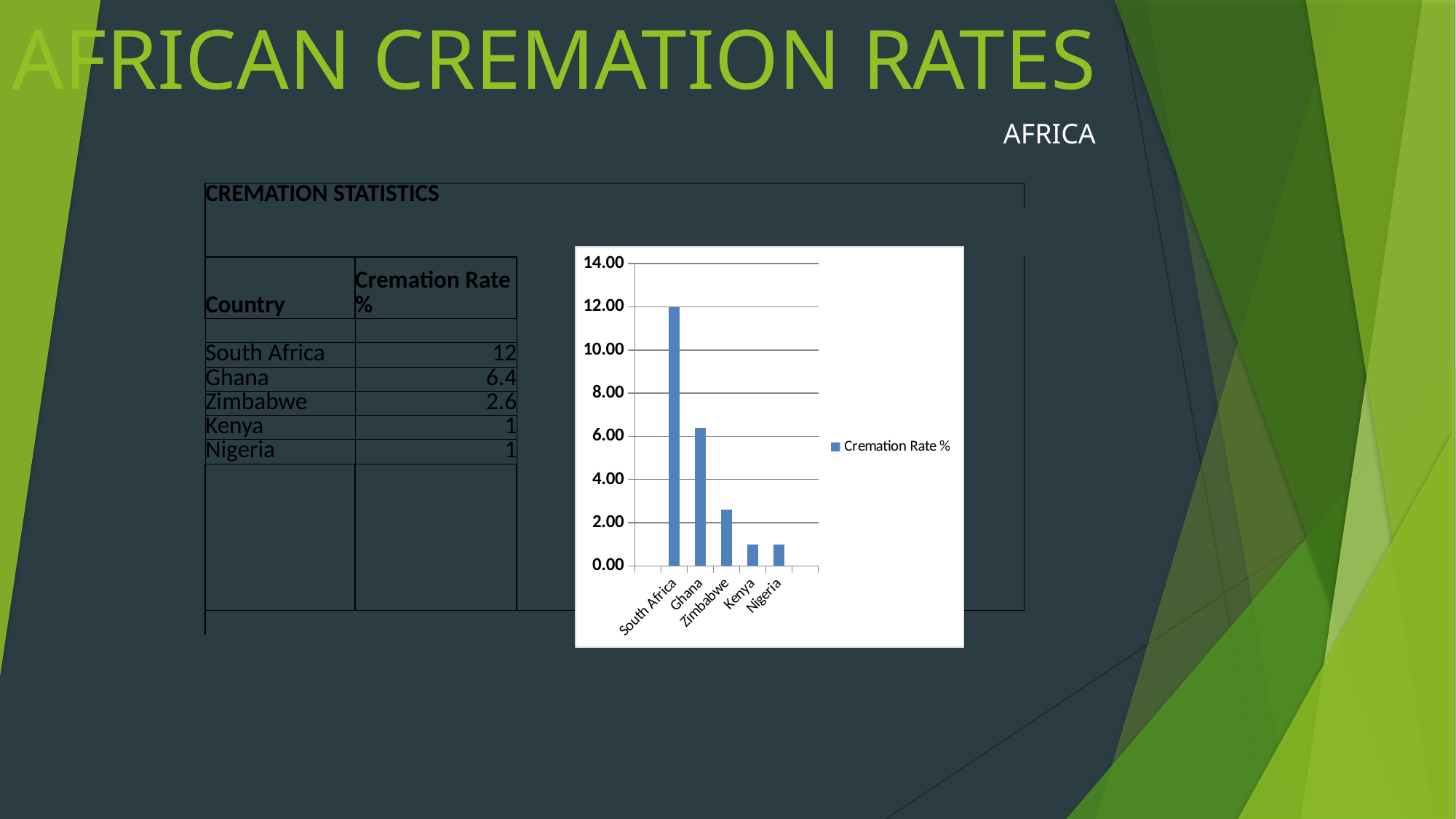
Which has a higher cremation rate, Ghana or Zimbabwe? Ghana Which country has the highest cremation rate in the chart? South Africa What is the cremation rate for South Africa? 12 How many countries are shown in the chart? 5 How many series does the chart legend list? 1 What is the cremation rate for Ghana? 6.4 What is the cremation rate for Zimbabwe? 2.6 What is the difference between the cremation rates of South Africa and Ghana? 5.6 What kind of chart is shown on the slide? bar chart Is the value for South Africa greater or less than 10.00? greater What is the legend entry shown in the chart? Cremation Rate % Is the value for Zimbabwe greater or less than 4.00? less